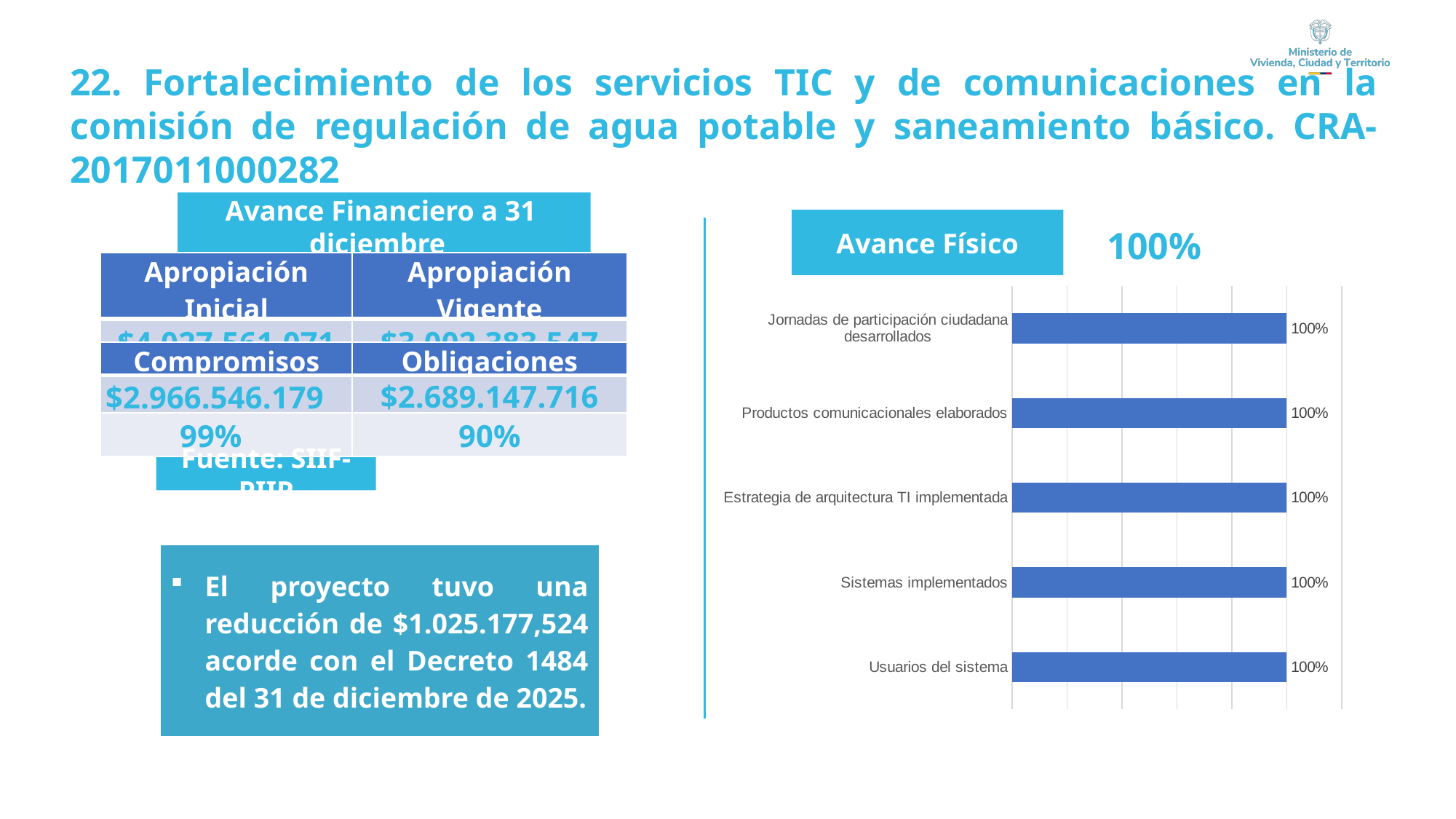
Which category is listed at the top of the Avance Físico chart? Jornadas de participación ciudadana desarrollados What is the difference between the values for "Usuarios del sistema" and "Sistemas implementados" in the Avance Físico chart? 0% What is the value for "Jornadas de participación ciudadana desarrollados" in the Avance Físico chart? 100% What colour are the bars in the Avance Físico chart? Blue What is the value for "Sistemas implementados" in the Avance Físico chart? 100% How many categories are shown in the Avance Físico chart? 5 What kind of chart is the Avance Físico chart? Bar chart What is the value for "Usuarios del sistema" in the Avance Físico chart? 100% What is the value for "Estrategia de arquitectura TI implementada" in the Avance Físico chart? 100% What is the value for "Productos comunicacionales elaborados" in the Avance Físico chart? 100%